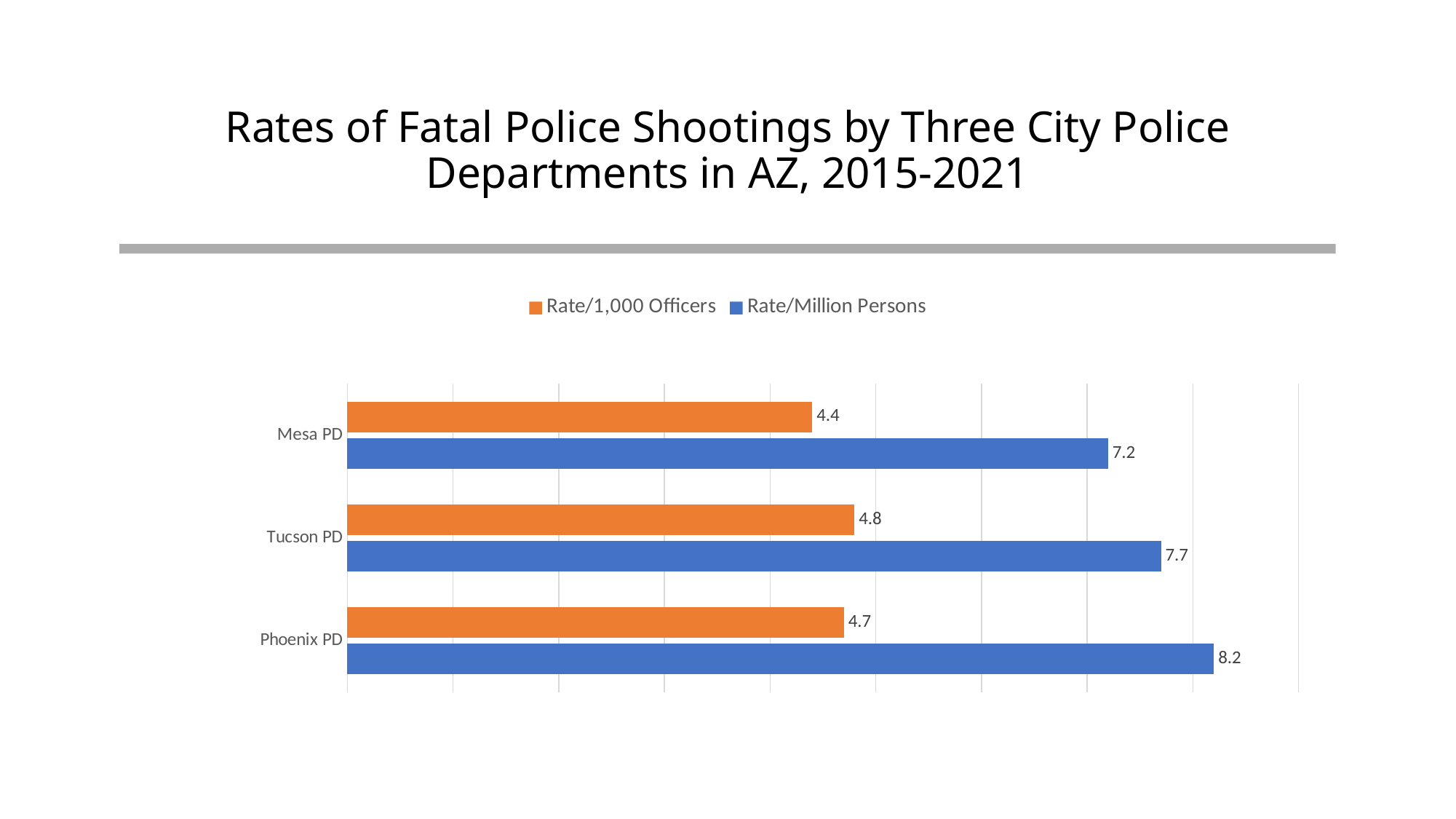
Which is larger for Mesa PD: the Rate/1,000 Officers or the Rate/Million Persons? Rate/Million Persons What is the Rate/1,000 Officers for Mesa PD? 4.4 What is the difference between the Rate/Million Persons for Phoenix PD and Mesa PD? 1.0 What is the Rate/1,000 Officers for Tucson PD? 4.8 How many police departments are shown in the chart? 3 Which colour represents the Rate/1,000 Officers series? Orange What is the Rate/Million Persons for Tucson PD? 7.7 Which police department has the highest Rate/Million Persons? Phoenix PD What is the Rate/Million Persons for Phoenix PD? 8.2 What kind of chart is shown on the slide? Bar chart How many series does the legend list? 2 Which police department has the lowest Rate/1,000 Officers? Mesa PD